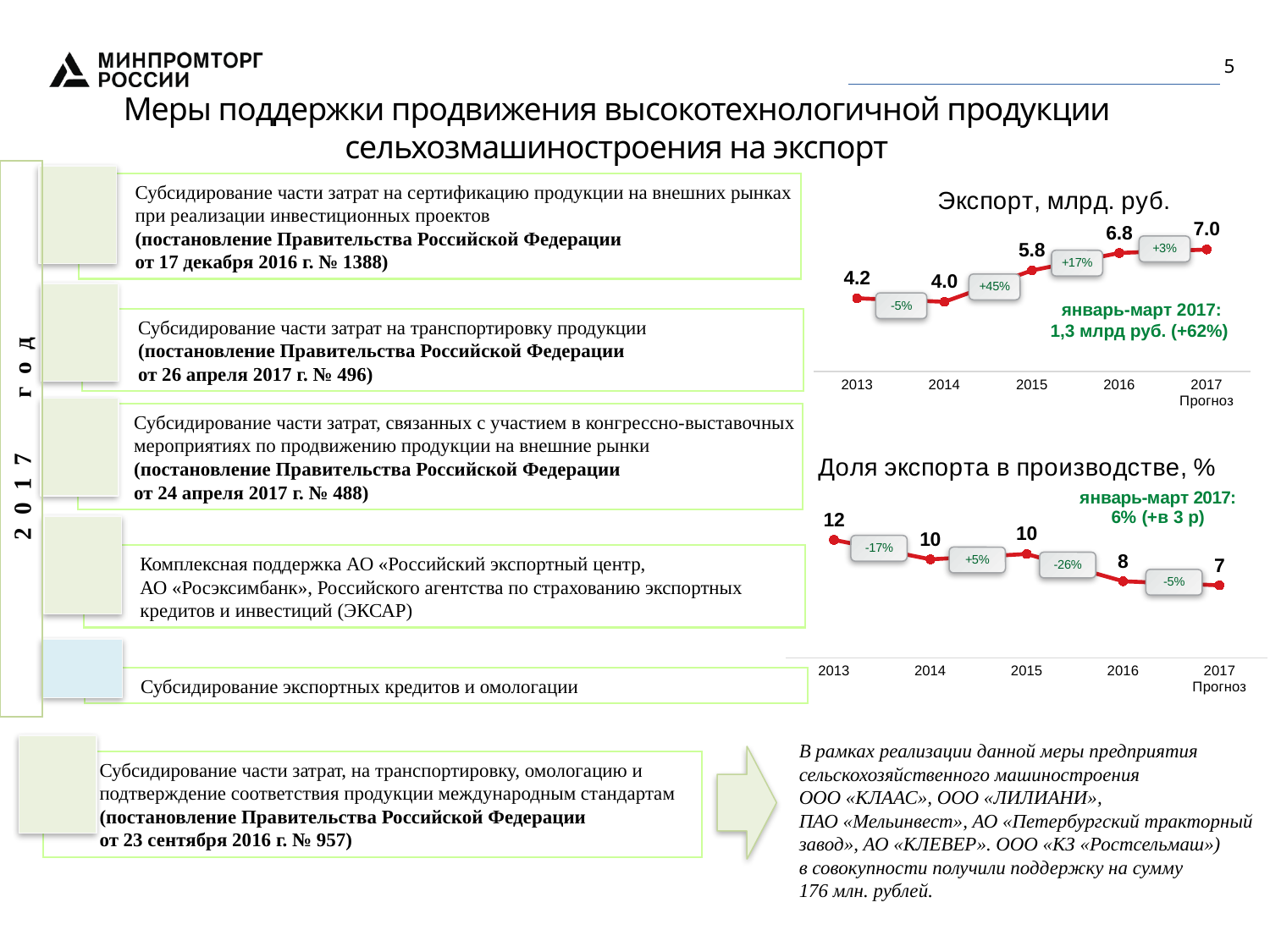
On the chart titled "Доля экспорта в производстве, %", what is the value for 2013? 12 On the chart titled "Доля экспорта в производстве, %", which year has the highest value? 2013 On the chart titled "Экспорт, млрд. руб.", what is the value for 2015? 5.8 On the chart titled "Экспорт, млрд. руб.", what is the difference between the 2016 value and the 2013 value? 2.6 On the chart titled "Экспорт, млрд. руб.", how many years are plotted? 5 On the chart titled "Доля экспорта в производстве, %", do the values generally rise or fall from 2013 to 2017? fall On the chart titled "Экспорт, млрд. руб.", what percentage change is shown between 2014 and 2015? +45% On the chart titled "Доля экспорта в производстве, %", is the value for 2016 larger or smaller than the value for 2015? smaller On the chart titled "Доля экспорта в производстве, %", what percentage change is shown between 2015 and 2016? -26% What type of chart is the chart titled "Доля экспорта в производстве, %"? line chart On the chart titled "Экспорт, млрд. руб.", which year has the lowest value? 2014 On the chart titled "Экспорт, млрд. руб.", what is the forecast value for 2017? 7.0